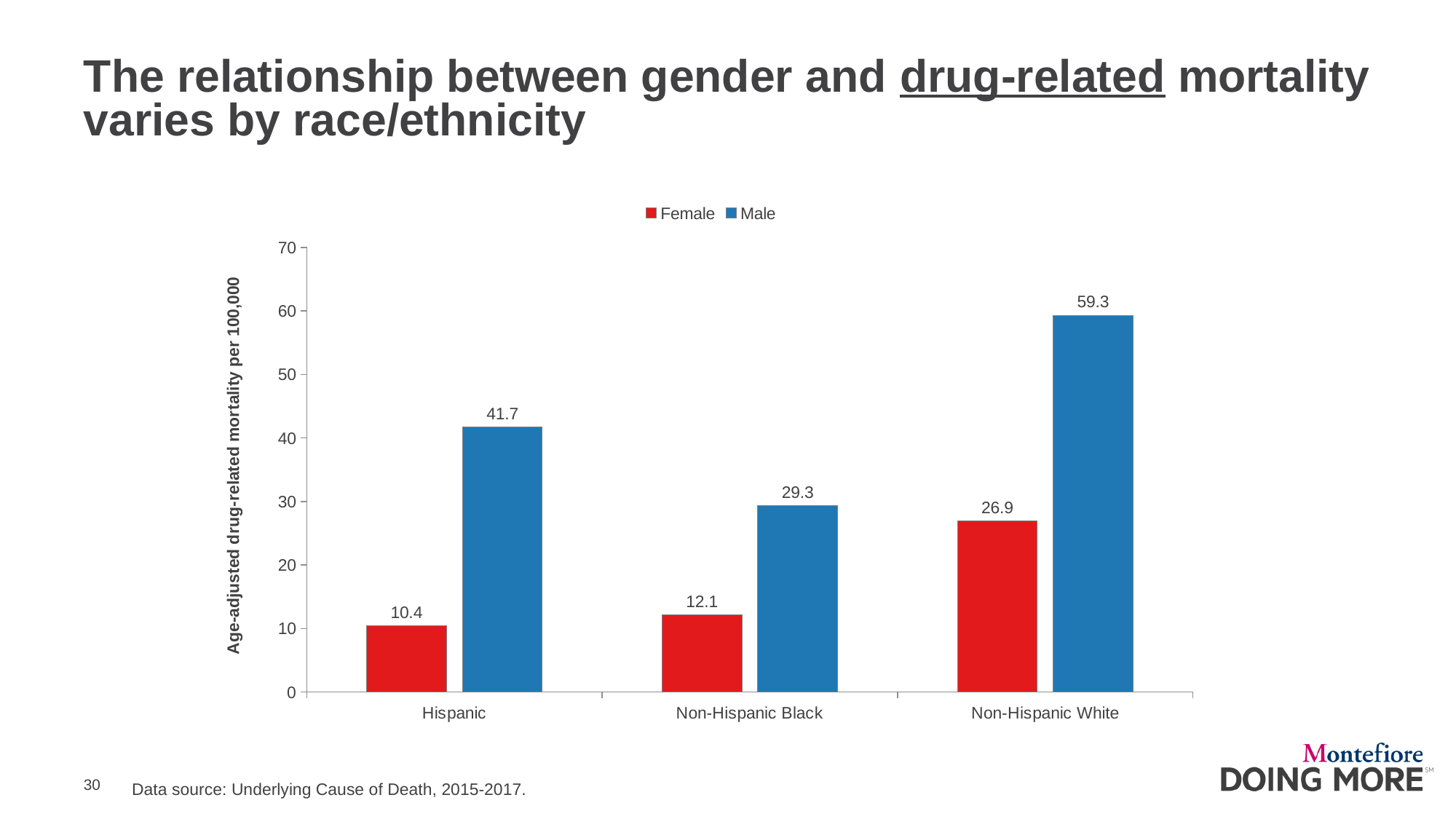
Which is larger, the female value for Non-Hispanic Black or the female value for Hispanic? Non-Hispanic Black What is the age-adjusted drug-related mortality per 100,000 for Non-Hispanic White males? 59.3 What kind of chart is shown on the slide? Bar chart Is the value for Hispanic males greater or less than 40? greater What is the difference between the male values for Hispanic and Non-Hispanic Black? 12.4 Which race/ethnicity group has the lowest male drug-related mortality? Non-Hispanic Black What is the value for Non-Hispanic Black males? 29.3 How many series does the legend list? 2 What is the age-adjusted drug-related mortality per 100,000 for Hispanic females? 10.4 How many race/ethnicity categories are shown on the x axis? 3 Which race/ethnicity group has the highest female drug-related mortality? Non-Hispanic White What is the difference between the male and female drug-related mortality for Non-Hispanic White? 32.4